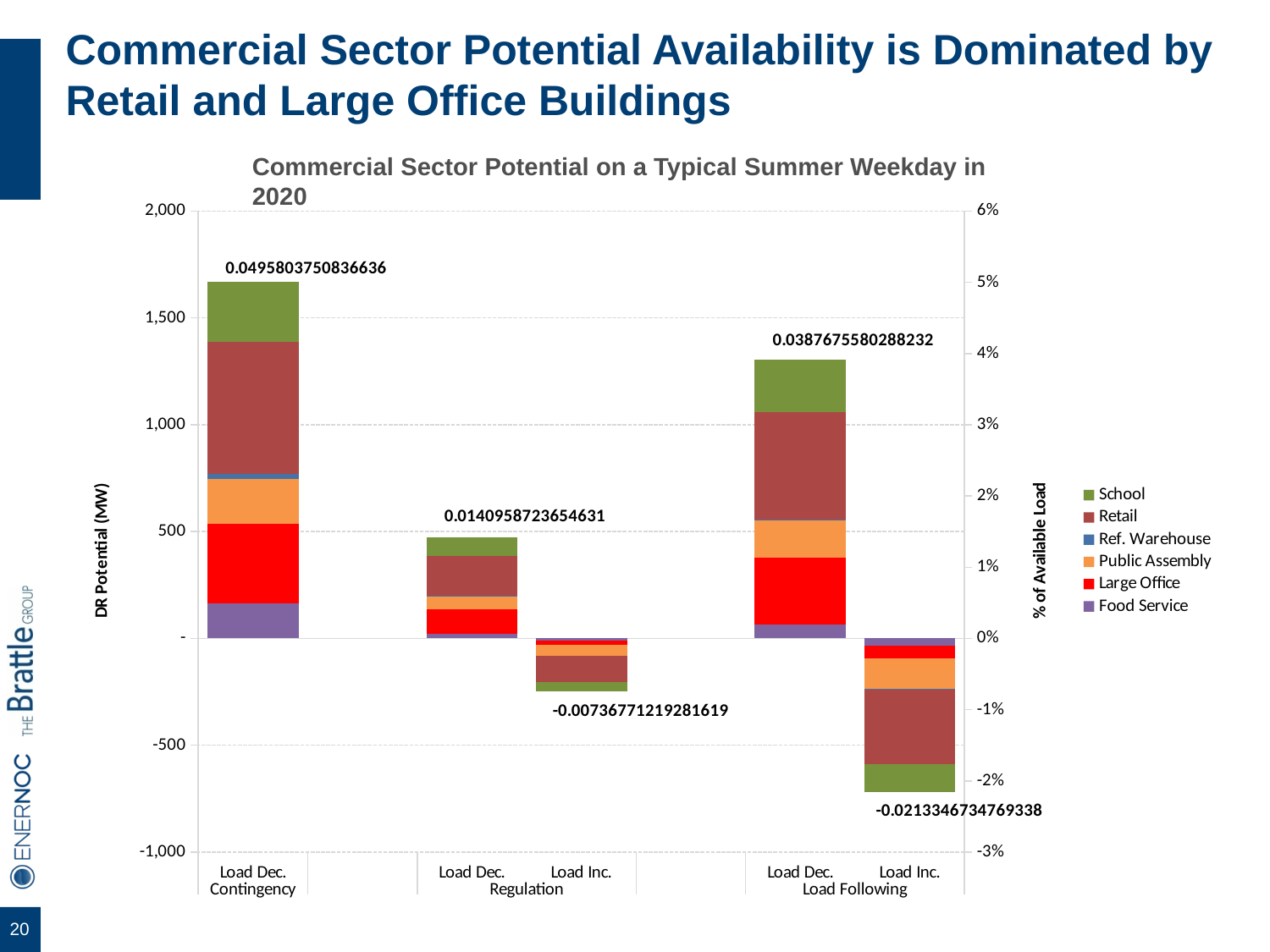
What data label is shown on the Load Dec. bar for Regulation? 0.0140958723654631 Which bar has the highest total DR potential? Load Dec. Contingency What data label is shown on the Load Inc. bar for Regulation? -0.00736771219281619 What kind of chart is shown on the slide? Stacked bar chart Is the total DR potential for the Load Dec. Contingency bar greater or less than 1,500 MW? greater Which is larger in total DR potential: the Load Dec. bar for Contingency or the Load Dec. bar for Load Following? Load Dec. Contingency Which bar has the lowest (most negative) total DR potential? Load Inc. Load Following How many bars are plotted in the chart? 5 Is the total DR potential for the Load Dec. Regulation bar greater or less than 500 MW? less What data label is shown on the Load Dec. bar for Contingency? 0.0495803750836636 What data label is shown on the Load Inc. bar for Load Following? -0.0213346734769338 How many series does the legend list? 6